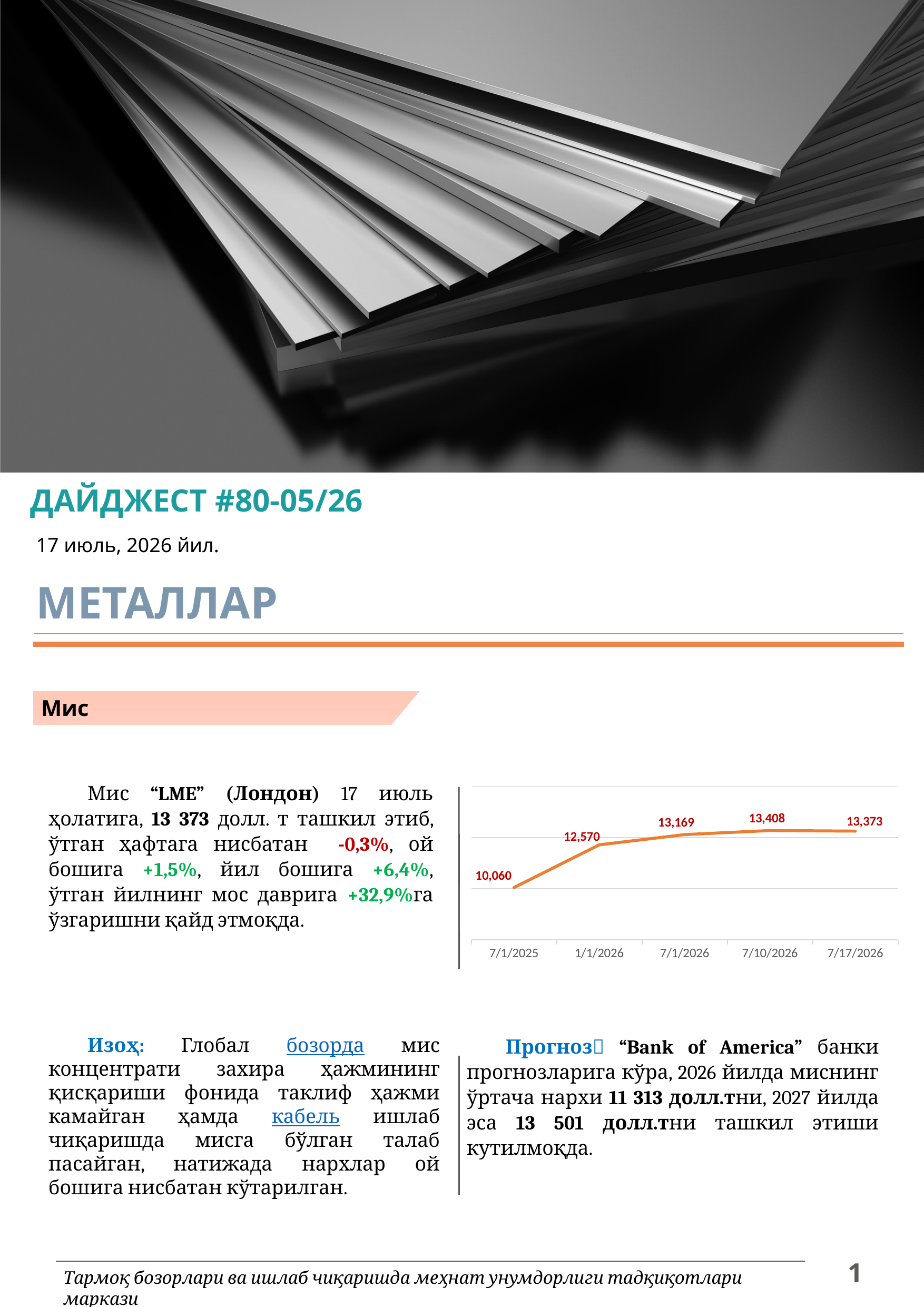
What colour is the line on the chart? orange Which is larger, the value for 7/1/2026 or the value for 1/1/2026? 7/1/2026 How many data points are plotted on the chart? 5 What is the value plotted for 7/17/2026? 13,373 What is the value plotted for 1/1/2026? 12,570 What is the value plotted for 7/1/2025? 10,060 What kind of chart is shown on the slide? line chart What is the value plotted for 7/10/2026? 13,408 What is the difference between the values for 1/1/2026 and 7/1/2025? 2,510 What is the difference between the values for 7/10/2026 and 7/17/2026? 35 Which date has the highest value on the chart? 7/10/2026 Which date has the lowest value on the chart? 7/1/2025